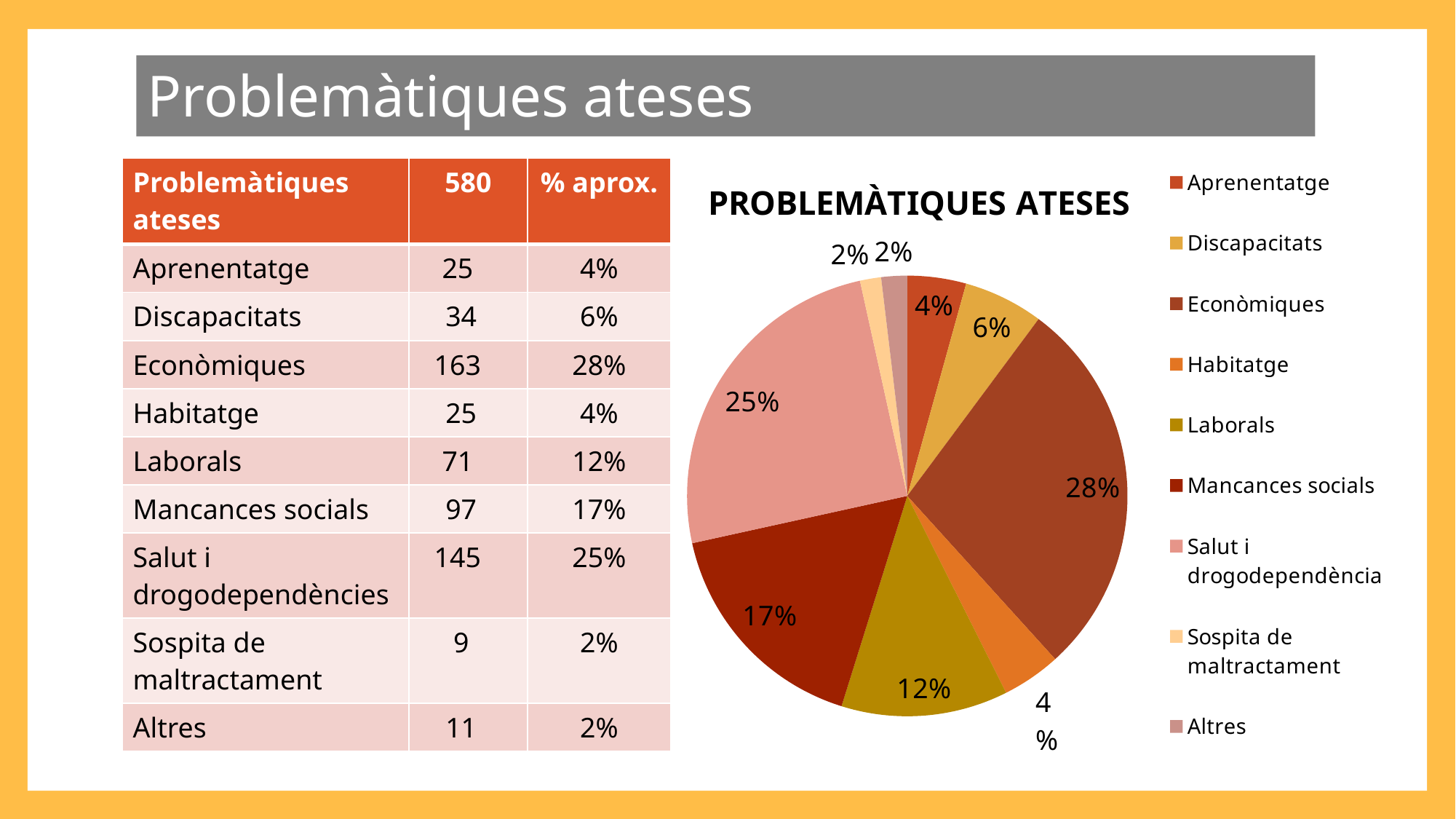
How many slices does the pie chart have? 9 What kind of chart is shown on the slide? pie chart What share of the pie does the Salut i drogodependència slice represent? 25% What share of the pie does the Econòmiques slice represent? 28% What share of the pie does the Mancances socials slice represent? 17% Which slice is larger, Mancances socials or Laborals? Mancances socials Which category has the largest slice of the pie? Econòmiques What is the title of the chart? PROBLEMÀTIQUES ATESES What is the difference in percentage points between the Econòmiques slice and the Salut i drogodependència slice? 3 How many entries does the legend list? 9